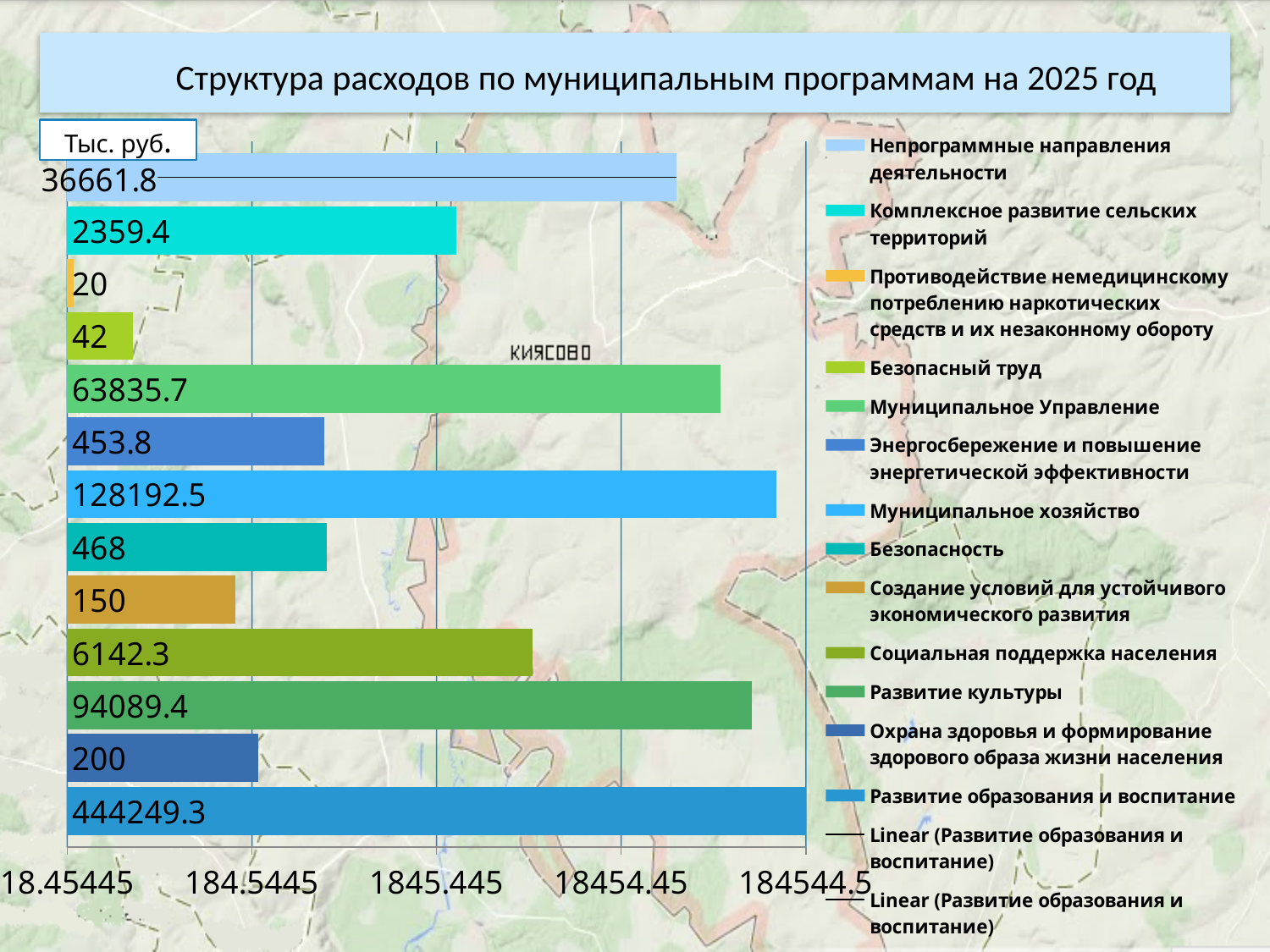
Which category has the highest value? Развитие образования и воспитание What is the value for Социальная поддержка населения? 6142.3 What is the value for Развитие образования и воспитание? 444249.3 What is the value for Муниципальное хозяйство? 128192.5 What kind of chart is shown on the slide? Bar chart What is the value for Безопасный труд? 42 What is the difference between the values for Безопасность and Энергосбережение и повышение энергетической эффективности? 14.2 Which is larger, the value for Муниципальное хозяйство or the value for Развитие культуры? Муниципальное хозяйство Which category has the lowest value? Противодействие немедицинскому потреблению наркотических средств и их незаконному обороту What unit is indicated for the values in the chart? Тыс. руб. What is the difference between the values for Охрана здоровья и формирование здорового образа жизни населения and Создание условий для устойчивого экономического развития? 50 How many bars are plotted in the chart? 13